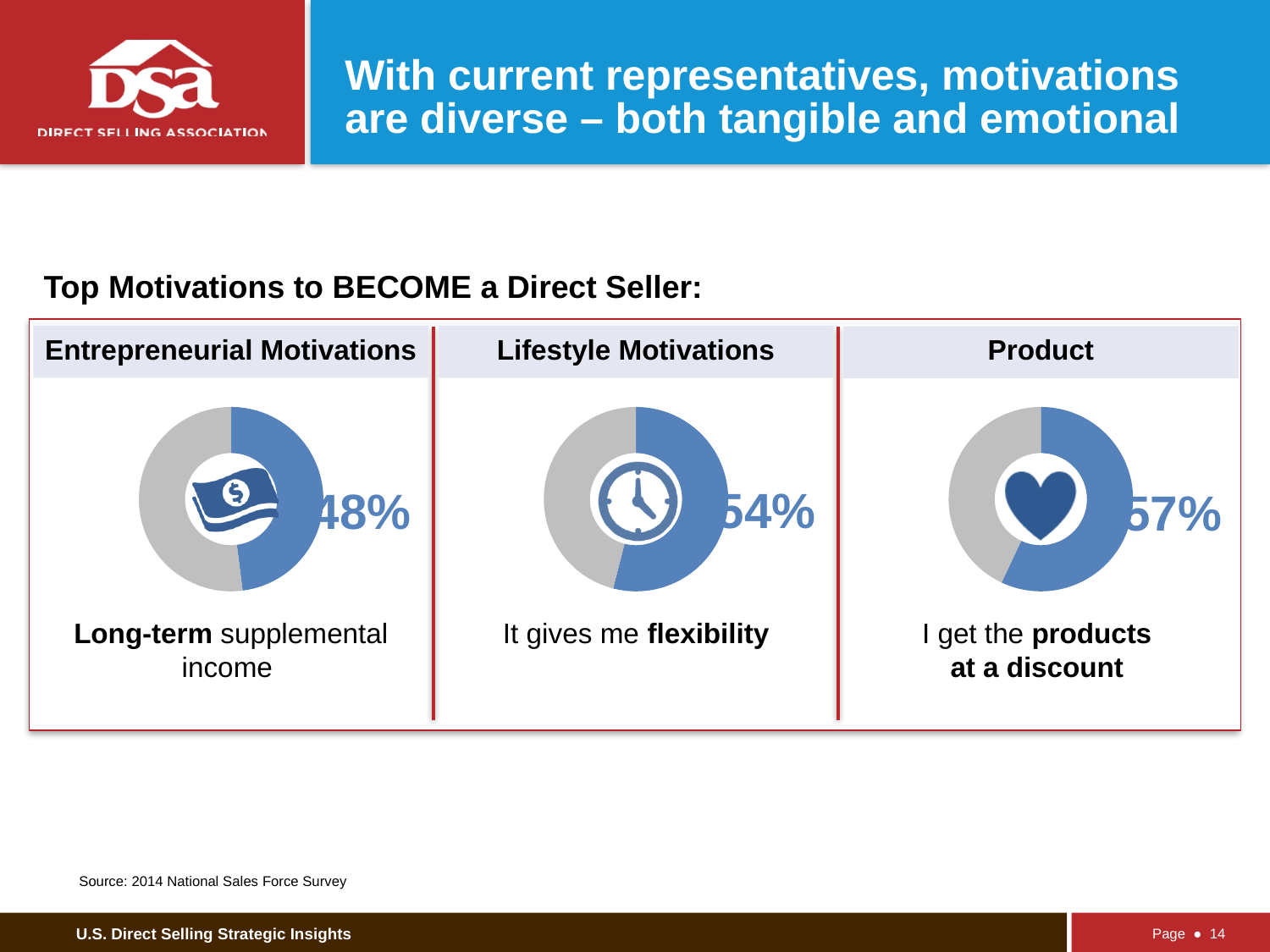
Which of the three motivation charts shows the lowest percentage? Entrepreneurial Motivations How many donut charts are shown on the slide? 3 What is the difference between the Lifestyle Motivations percentage and the Entrepreneurial Motivations percentage? 6% Which of the three motivation charts shows the highest percentage? Product What percentage is shown in the Product donut chart? 57% What kind of chart is used to show each motivation percentage on the slide? Donut chart Which is larger: the Lifestyle Motivations percentage or the Product percentage? Product What motivation is described under the Lifestyle Motivations chart? It gives me flexibility What percentage is shown in the Lifestyle Motivations donut chart? 54% What is the difference between the Product percentage and the Entrepreneurial Motivations percentage? 9% What motivation is described under the Product chart? I get the products at a discount What percentage is shown in the Entrepreneurial Motivations donut chart? 48%